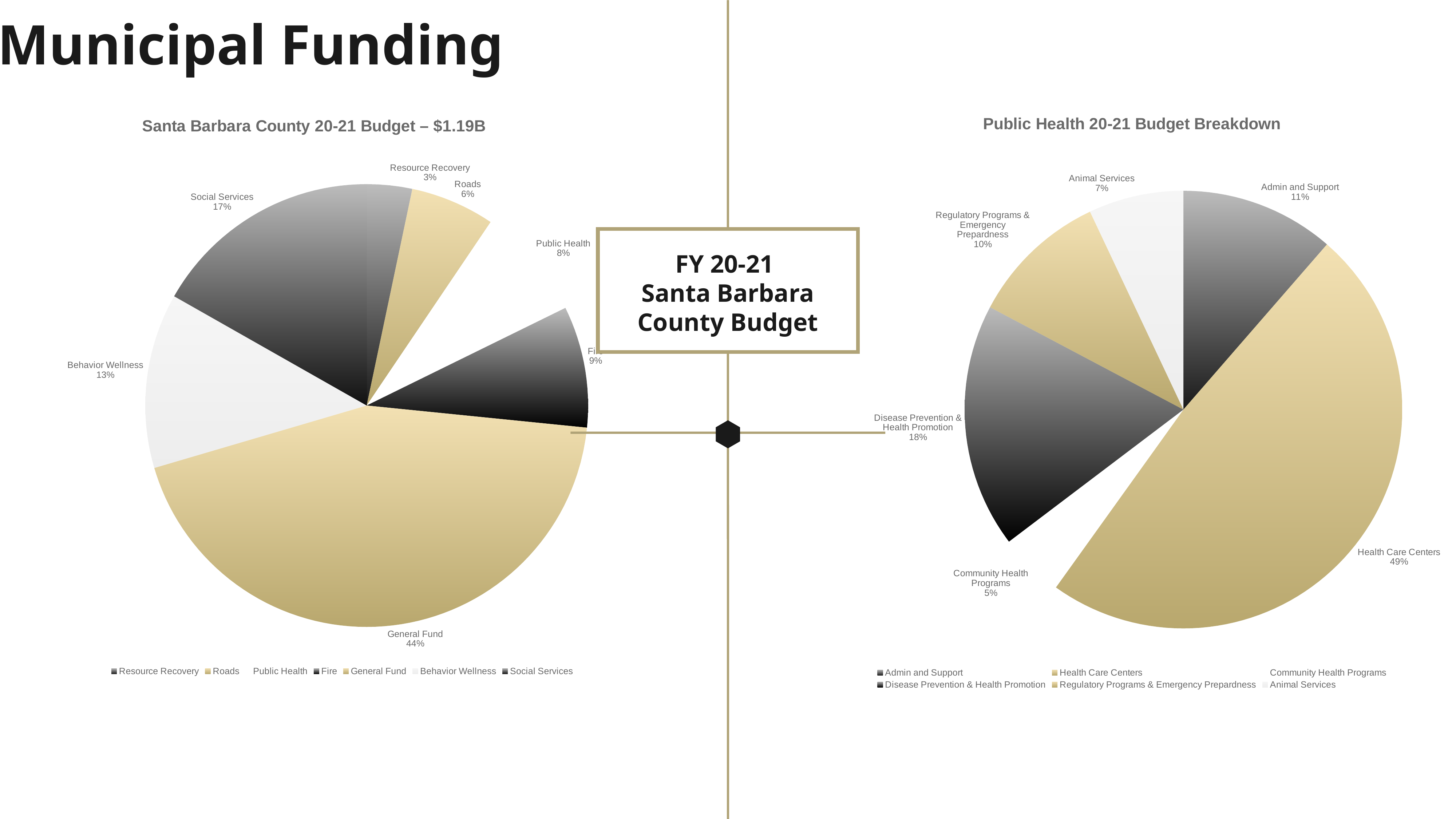
In the 'Public Health 20-21 Budget Breakdown' chart, what percentage is Disease Prevention & Health Promotion? 18% In the 'Public Health 20-21 Budget Breakdown' chart, what share goes to Health Care Centers? 49% In the 'Santa Barbara County 20-21 Budget – $1.19B' chart, what percentage is Social Services? 17% In the 'Public Health 20-21 Budget Breakdown' chart, how many categories does the legend list? 6 In the 'Santa Barbara County 20-21 Budget – $1.19B' chart, what is the difference between the Behavior Wellness and Public Health shares? 5% In the 'Santa Barbara County 20-21 Budget – $1.19B' chart, what share of the budget goes to the General Fund? 44% In the 'Santa Barbara County 20-21 Budget – $1.19B' chart, which is larger, Fire or Roads? Fire In the 'Santa Barbara County 20-21 Budget – $1.19B' chart, how many categories are shown? 7 In the 'Public Health 20-21 Budget Breakdown' chart, what is the difference between Admin and Support and Community Health Programs? 6% What kind of chart is the 'Public Health 20-21 Budget Breakdown'? Pie chart In the 'Santa Barbara County 20-21 Budget – $1.19B' chart, which category has the smallest share? Resource Recovery In the 'Public Health 20-21 Budget Breakdown' chart, which category has the largest share? Health Care Centers